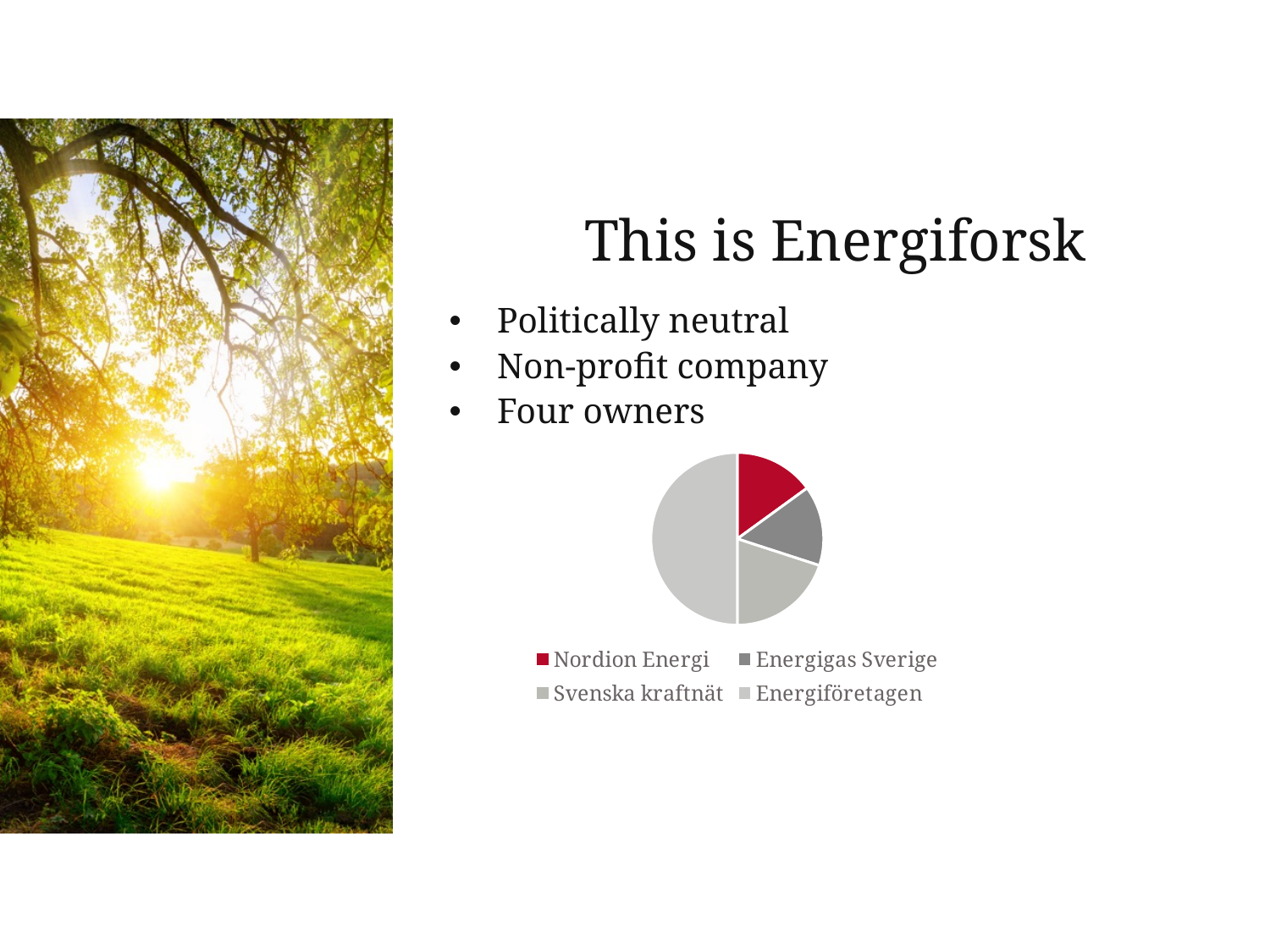
What colour is the Nordion Energi slice in the pie chart? Red What kind of chart is shown on the slide? Pie chart Which owner has the largest slice of the pie chart? Energiföretagen How many slices does the pie chart have? 4 Which slice is larger in the pie chart, Energiföretagen or Nordion Energi? Energiföretagen Which slice is larger in the pie chart, Energiföretagen or Svenska kraftnät? Energiföretagen Which slice is larger in the pie chart, Svenska kraftnät or Energigas Sverige? Svenska kraftnät Which legend entry is listed first in the pie chart's legend? Nordion Energi How many entries does the legend of the pie chart list? 4